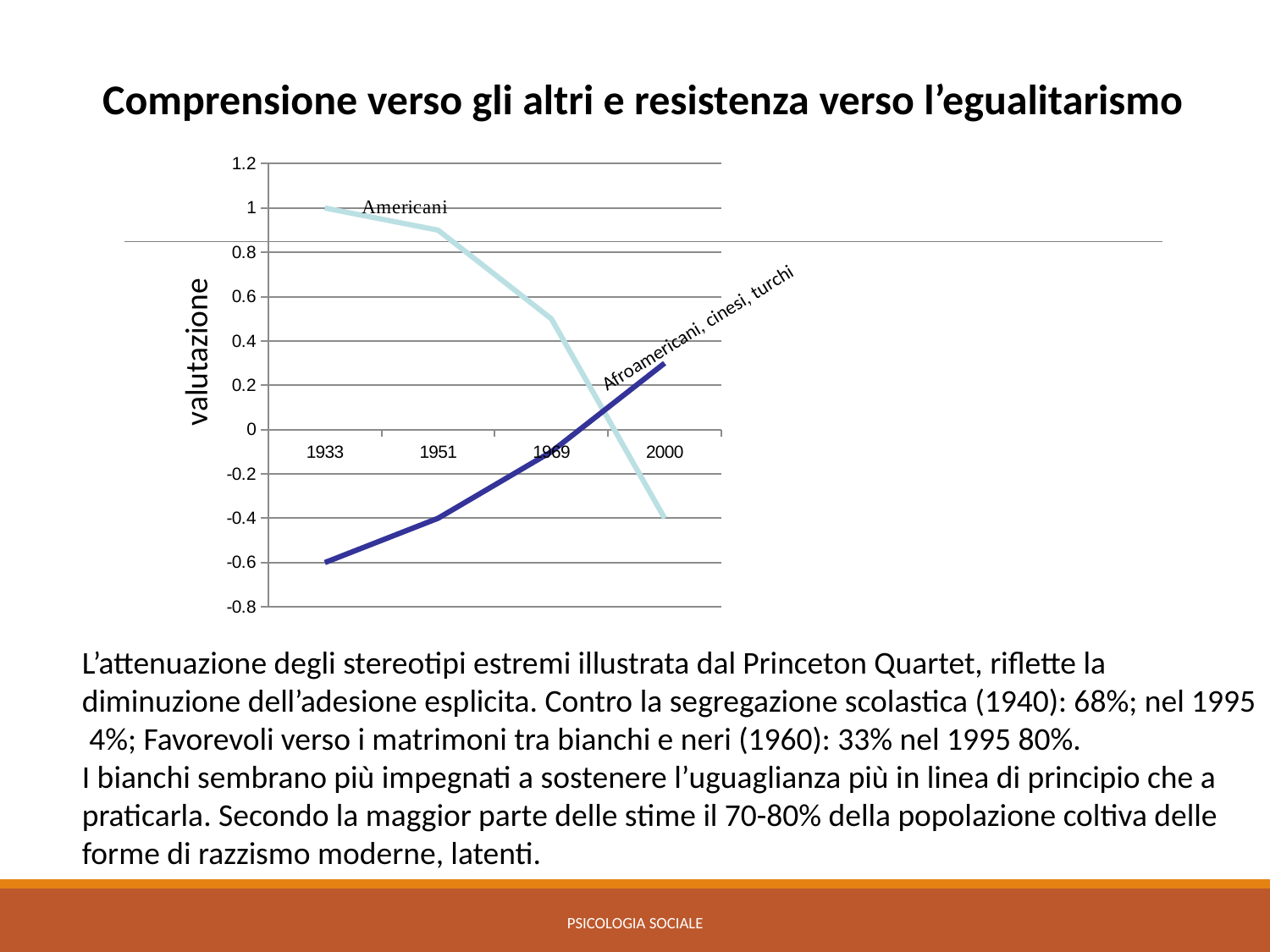
What kind of chart is shown on the slide? line chart What is the value for Afroamericani, cinesi, turchi in 1933? -0.6 Is the value for Afroamericani, cinesi, turchi in 2000 greater or less than 0.2? greater What is the value for Americani in 1933? 1 Which series has the higher value in 2000, Americani or Afroamericani, cinesi, turchi? Afroamericani, cinesi, turchi How many series are plotted in the chart? 2 Does the Americani line rise or fall from 1933 to 2000? fall What is the value for Americani in 2000? -0.4 What is the label on the y axis of the chart? valutazione How many years are marked on the x axis of the chart? 4 Is the value for Americani in 1969 greater or less than 0.6? less Does the Afroamericani, cinesi, turchi line rise or fall from 1933 to 2000? rise